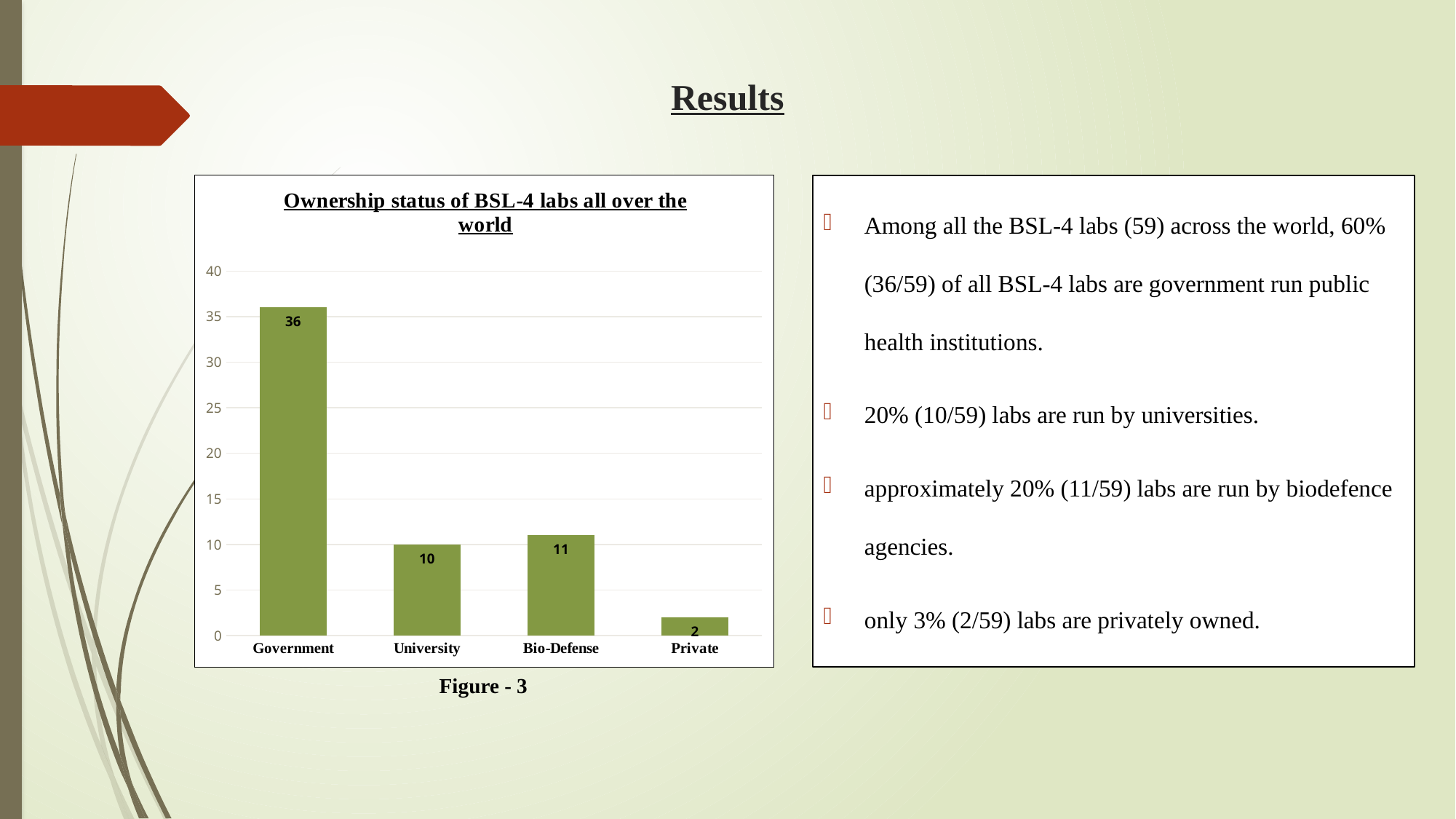
How many categories are shown on the x axis of the chart? 4 What is the difference between the values for Government and University? 26 What is the value for University in the chart? 10 What is the value for Government in the chart? 36 What kind of chart is shown on the slide? Bar chart What is the difference between the values for Bio-Defense and Private? 9 Which is larger, the value for Bio-Defense or the value for University? Bio-Defense Which category has the lowest value? Private What is the value for Private in the chart? 2 What is the value for Bio-Defense in the chart? 11 What is the title of the chart? Ownership status of BSL-4 labs all over the world Which category has the highest value? Government